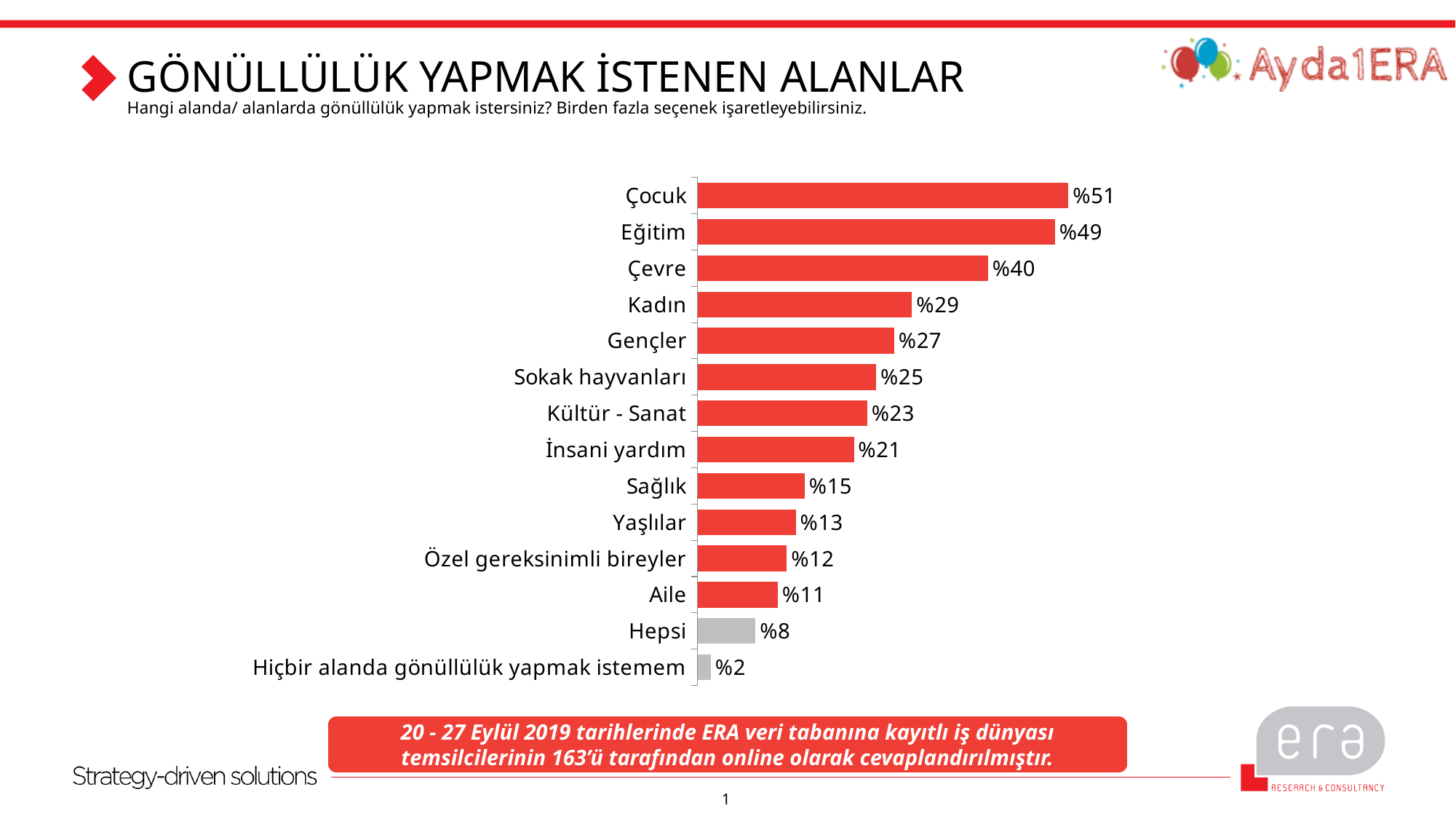
What is the value for Çocuk? %51 What is the difference between the values for Sağlık and Aile? 4 percentage points Which category has the lowest value? Hiçbir alanda gönüllülük yapmak istemem How many categories are shown in the chart? 14 Which two categories are shown with grey bars instead of red? Hepsi and Hiçbir alanda gönüllülük yapmak istemem What kind of chart is shown on the slide? Bar chart What is the value for Hepsi? %8 Which is larger, the value for Kadın or the value for Gençler? Kadın What is the value for Sokak hayvanları? %25 Which category has the highest value? Çocuk What is the value for Özel gereksinimli bireyler? %12 What is the difference between the values for Eğitim and Çevre? 9 percentage points